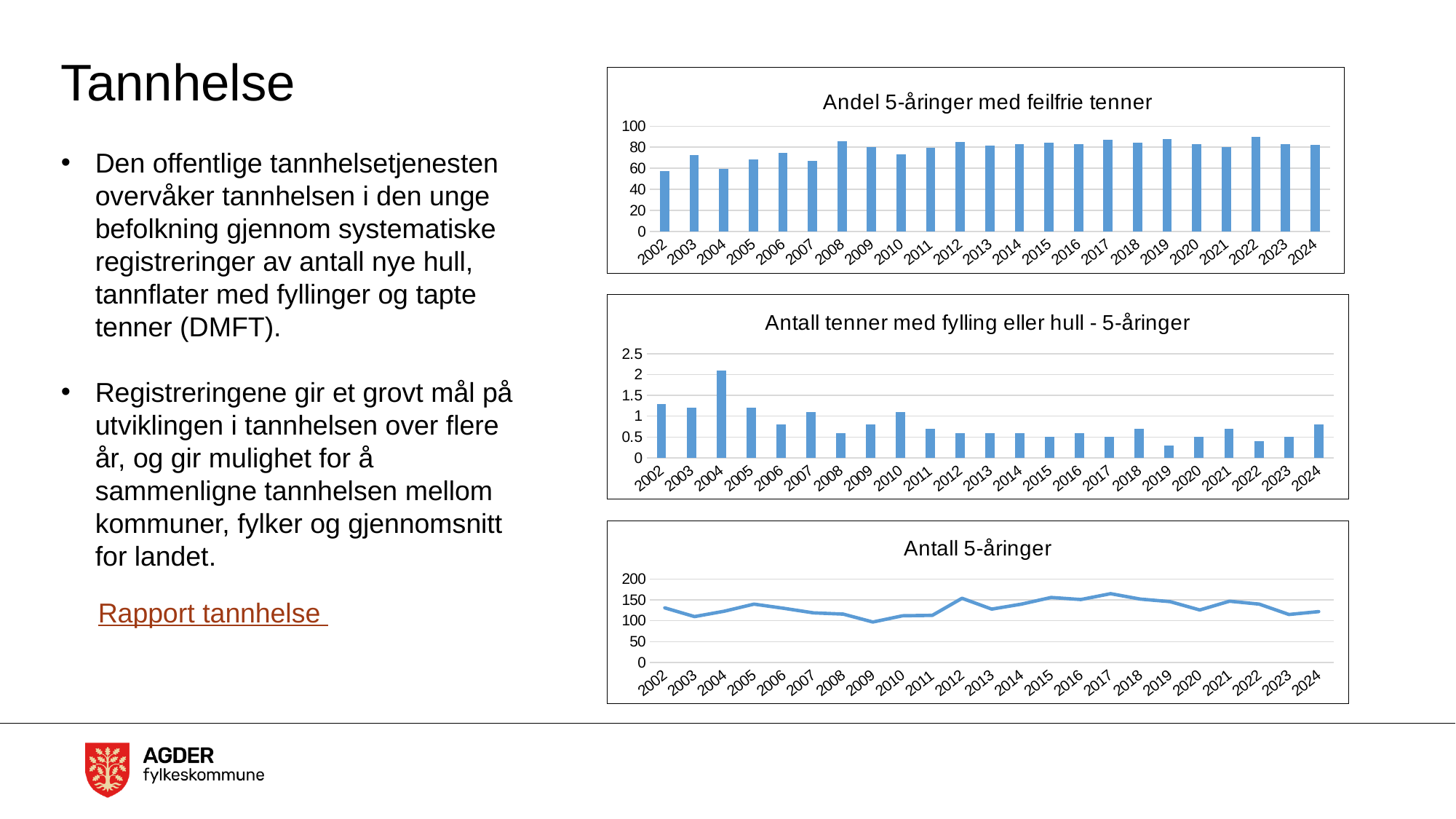
In the bottom chart 'Antall 5-åringer', is the value for 2017 greater or less than 150? greater In the top chart 'Andel 5-åringer med feilfrie tenner', is the value for 2008 greater or less than 80? greater In the middle chart 'Antall tenner med fylling eller hull - 5-åringer', which year has the lowest value? 2019 In the middle chart 'Antall tenner med fylling eller hull - 5-åringer', which year has the highest value? 2004 In the top chart 'Andel 5-åringer med feilfrie tenner', which year has the lowest value? 2002 What kind of chart is the top chart, 'Andel 5-åringer med feilfrie tenner'? bar chart In the top chart 'Andel 5-åringer med feilfrie tenner', how many years are shown on the x axis? 23 In the middle chart 'Antall tenner med fylling eller hull - 5-åringer', which is larger, the value for 2004 or the value for 2024? 2004 What kind of chart is the bottom chart, 'Antall 5-åringer'? line chart In the middle chart 'Antall tenner med fylling eller hull - 5-åringer', is the value for 2004 greater or less than 2? greater In the bottom chart 'Antall 5-åringer', which year has the lowest value? 2009 In the top chart 'Andel 5-åringer med feilfrie tenner', do the values generally rise or fall from 2002 to 2024? rise